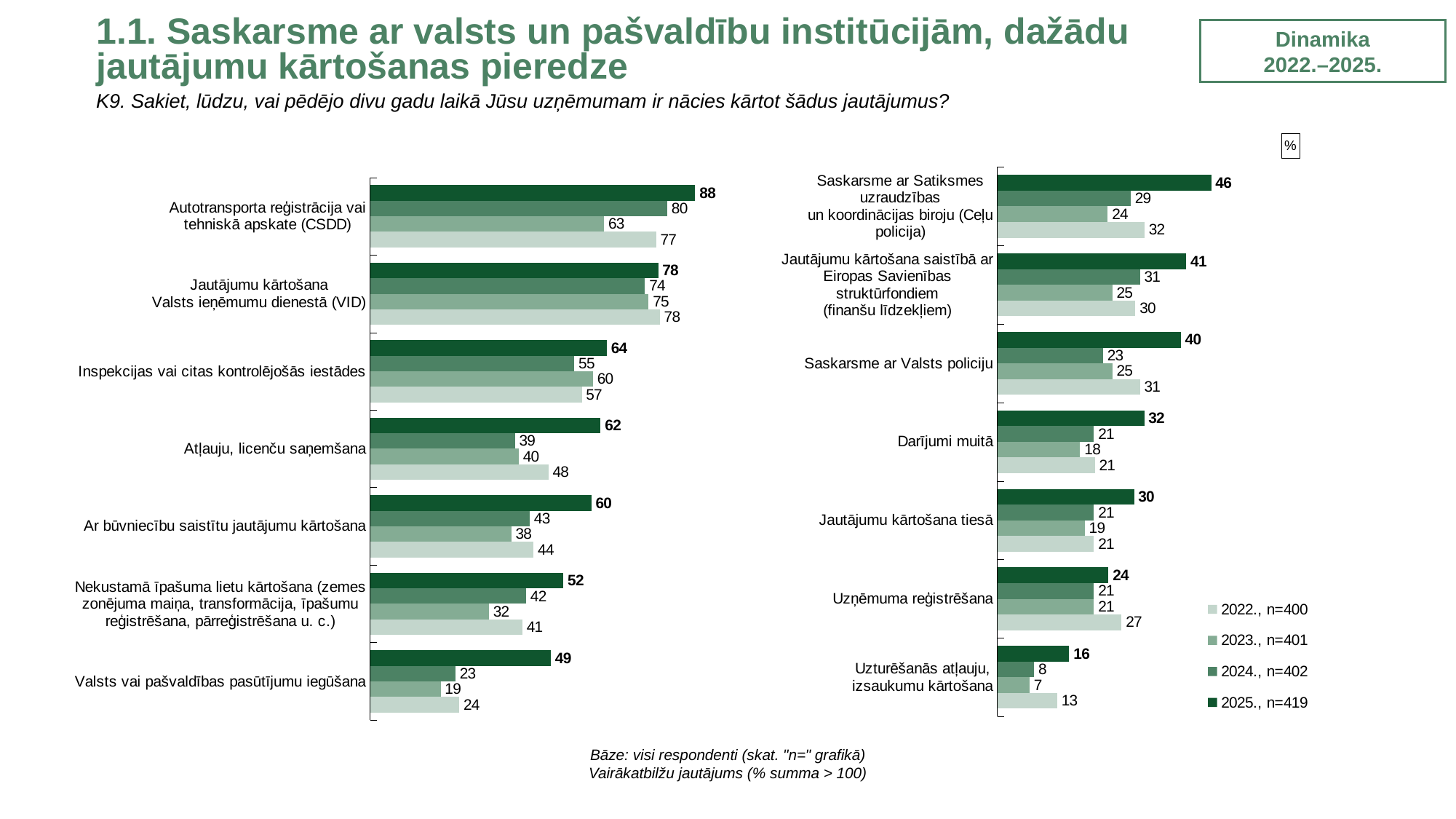
In the left chart, which is larger for Ar būvniecību saistītu jautājumu kārtošana: the 2022 value or the 2023 value? 2022 How many categories are shown in the left chart? 7 According to the legend, what is the sample size (n) for 2025? 419 What type of chart is used on this slide? Bar chart How many series does the legend list? 4 In the left chart, what is the 2025 value for Autotransporta reģistrācija vai tehniskā apskate (CSDD)? 88 In the left chart, what is the 2023 value for Atļauju, licenču saņemšana? 40 In the right chart, which category has the highest 2025 value? Saskarsme ar Satiksmes uzraudzības un koordinācijas biroju (Ceļu policija) In the left chart, what is the difference between the 2025 and 2024 values for Valsts vai pašvaldības pasūtījumu iegūšana? 26 In the right chart, what is the 2022 value for Uzņēmuma reģistrēšana? 27 In the right chart, which category has the lowest 2024 value? Uzturēšanās atļauju, izsaukumu kārtošana In the right chart, what is the difference between the 2025 and 2022 values for Darījumi muitā? 11